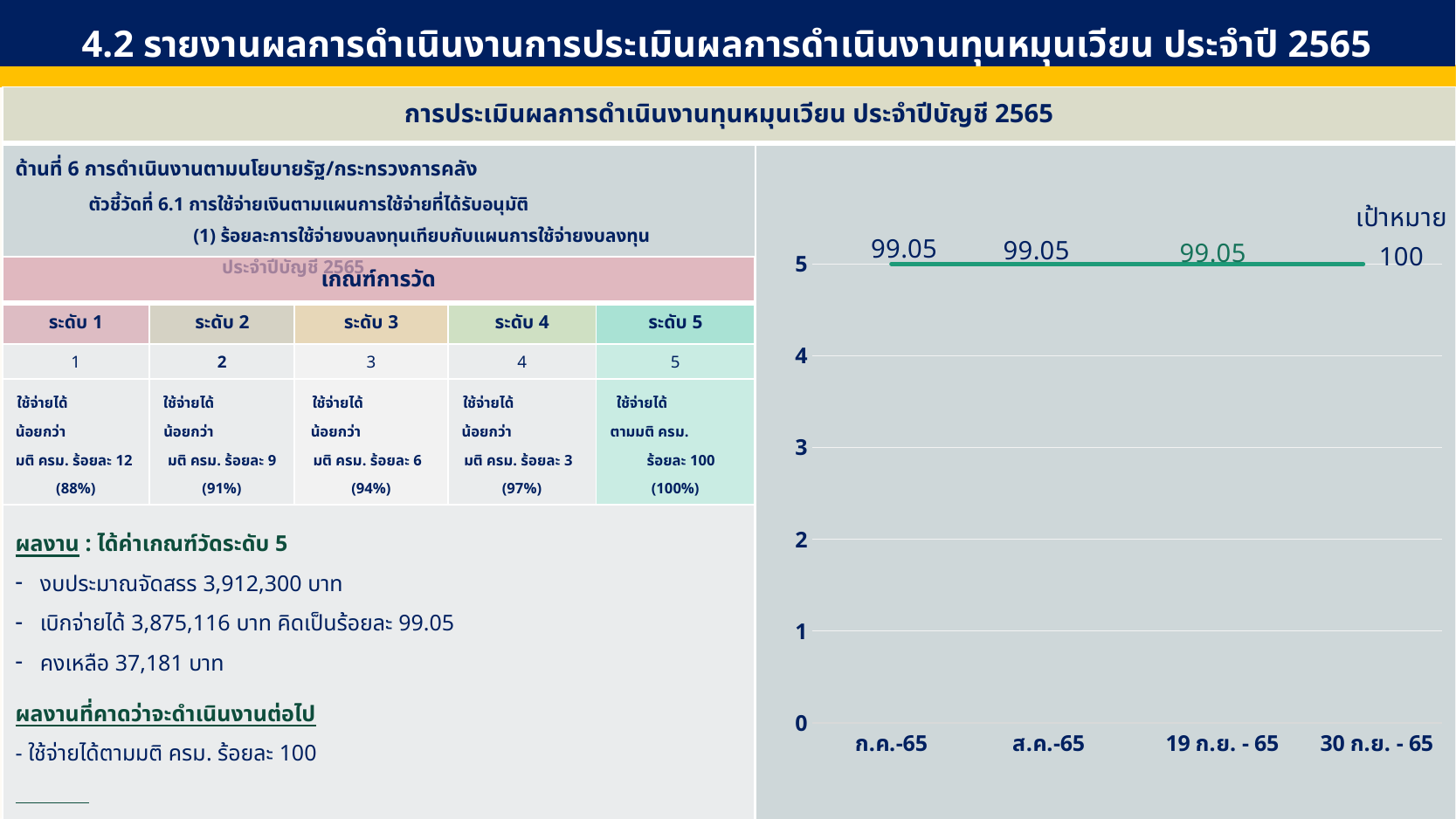
What value is labelled for ส.ค.-65 on the chart? 99.05 What word is written above the value 100 at the right end of the chart? เป้าหมาย What colour is the plotted line on the chart? green What value is labelled for 30 ก.ย. - 65 on the chart? 100 What value is labelled for 19 ก.ย. - 65 on the chart? 99.05 What is the highest tick value shown on the y axis of the chart? 5 What value is labelled for ก.ค.-65 on the chart? 99.05 Is the level of the plotted line greater or less than 3 on the y axis? greater Does the plotted line rise, fall, or stay flat from ก.ค.-65 to 30 ก.ย. - 65? stays flat What kind of chart is shown on the right side of the slide? line chart What is the difference between the value labelled for 30 ก.ย. - 65 and the value labelled for 19 ก.ย. - 65? 0.95 How many categories are shown on the x axis of the chart? 4